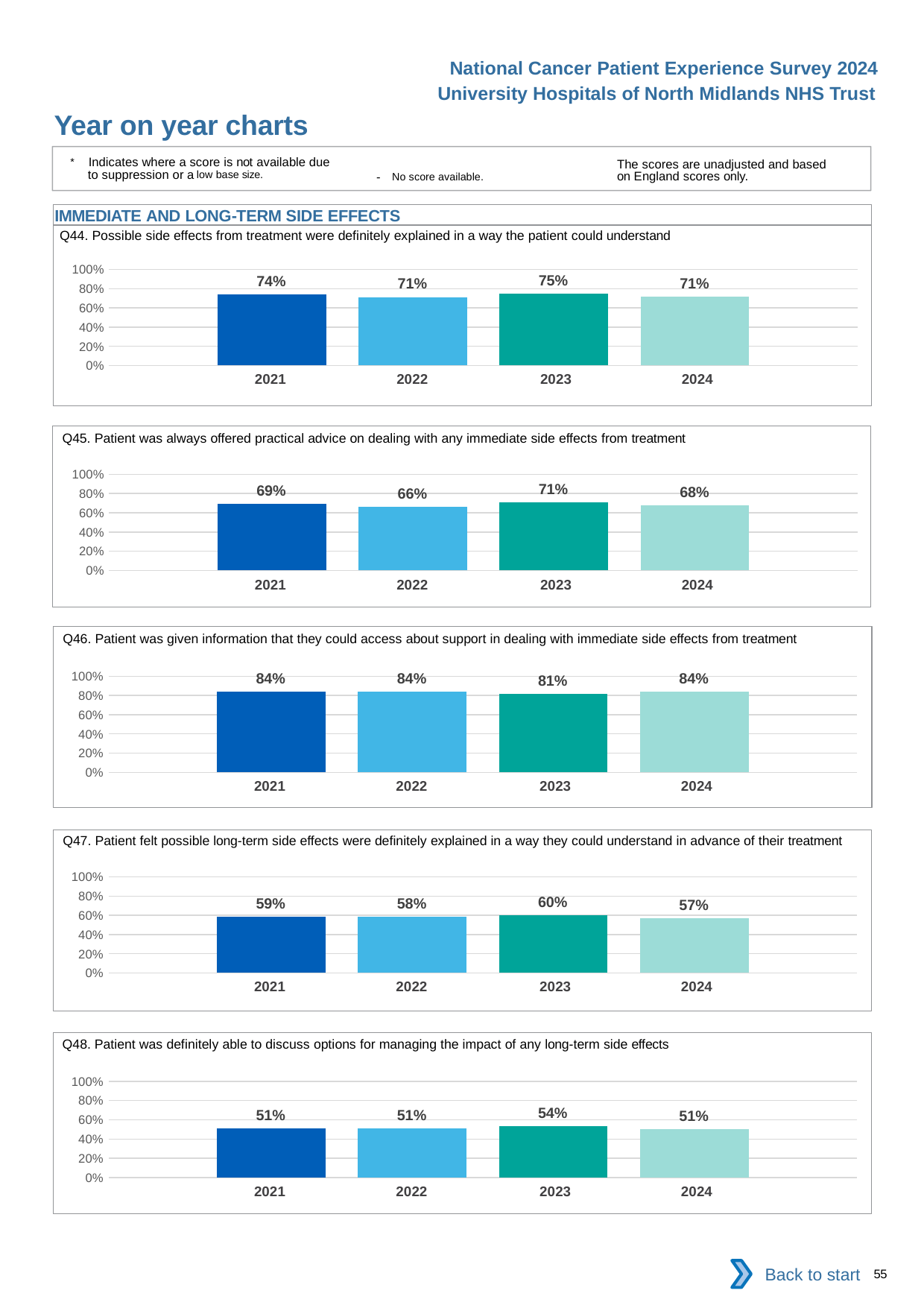
In the Q47 chart, what is the difference between the 2021 value and the 2024 value? 2% What is the section heading above the Q44 chart? IMMEDIATE AND LONG-TERM SIDE EFFECTS In the Q48 chart, what is the difference between the 2023 value and the 2024 value? 3% In the Q47 chart, which year has the highest value? 2023 In the Q48 chart, is the value for 2023 greater or less than 60%? less What kind of chart is the Q47 chart? Bar chart In the Q46 chart, what is the value for 2023? 81% In the Q44 chart, what is the value for 2023? 75% In the Q45 chart, which year has the lowest value? 2022 In the Q46 chart, what is the value for 2021? 84% In the Q44 chart, which is larger, the value for 2021 or the value for 2022? 2021 In the Q45 chart, how many years are plotted? 4